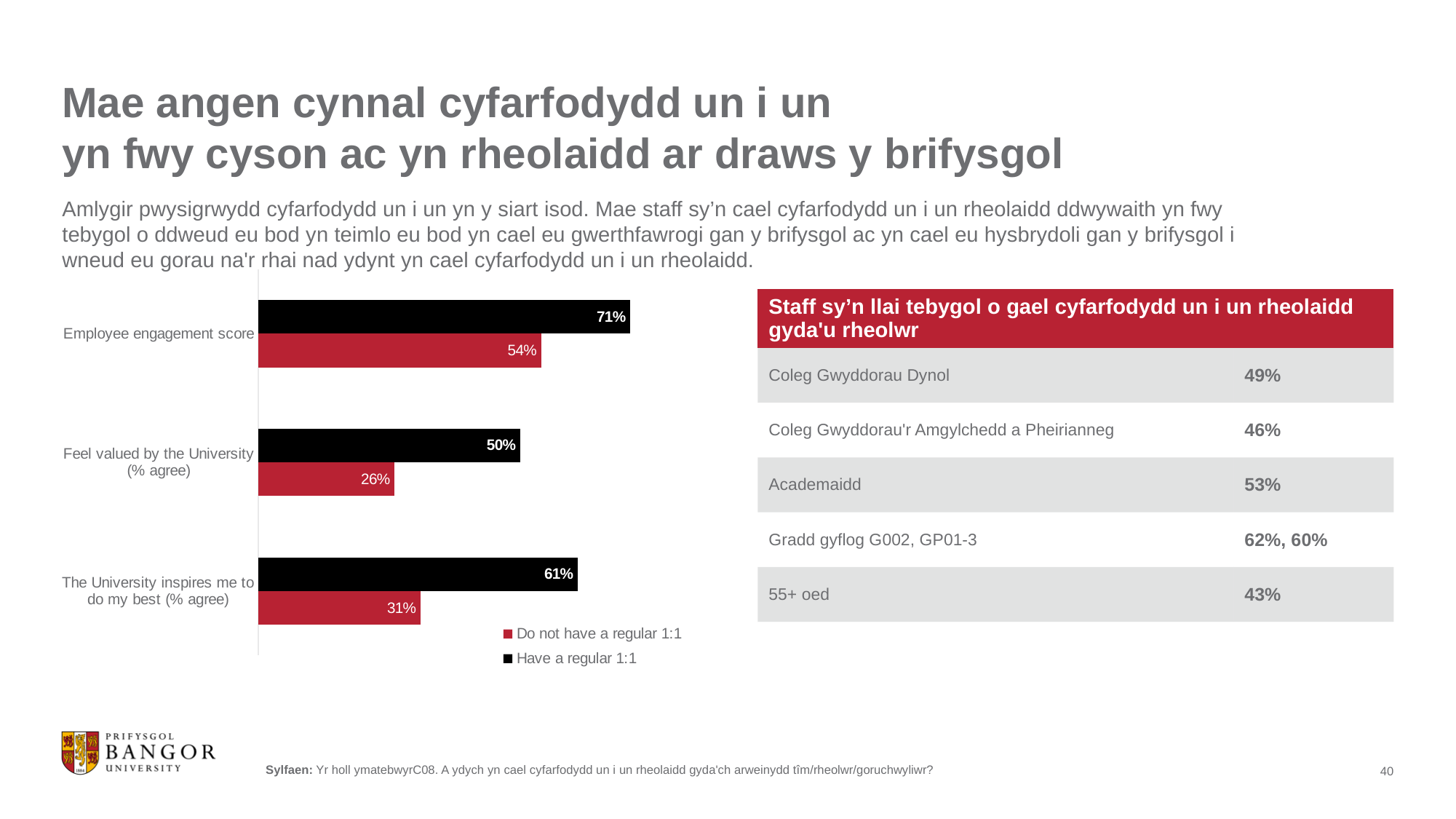
What percentage of staff who do not have a regular 1:1 feel valued by the University? 26% Which category has the lowest value for the 'Do not have a regular 1:1' series? Feel valued by the University (% agree) How many series does the chart legend list? 2 What is the Employee engagement score for staff who have a regular 1:1? 71% How many categories are shown on the bar chart? 3 For 'Employee engagement score', which series has the larger value: 'Have a regular 1:1' or 'Do not have a regular 1:1'? Have a regular 1:1 Which category has the highest value for the 'Have a regular 1:1' series? Employee engagement score What is the difference between the 'Have a regular 1:1' and 'Do not have a regular 1:1' values for 'Feel valued by the University (% agree)'? 24% What percentage of staff who have a regular 1:1 agree that the University inspires them to do their best? 61% What is the Employee engagement score for staff who do not have a regular 1:1? 54% What is the difference between the 'Have a regular 1:1' and 'Do not have a regular 1:1' values for 'The University inspires me to do my best (% agree)'? 30% What type of chart is shown on the slide? Bar chart